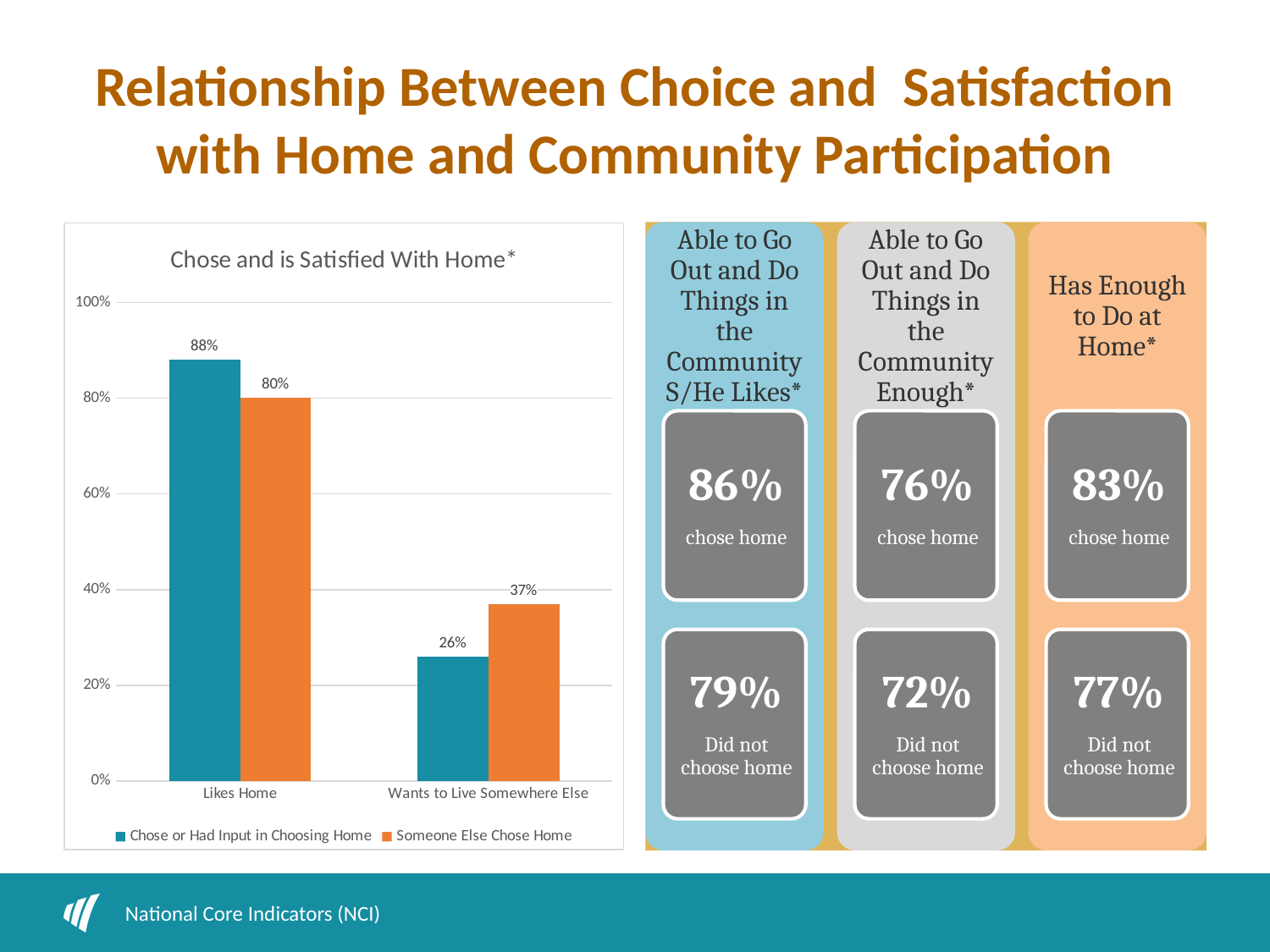
How many series does the chart legend list? 2 What is the difference between the two series' values in the 'Likes Home' category? 8% What is the value for 'Someone Else Chose Home' in the 'Likes Home' category? 80% How many categories are shown on the x axis of the chart? 2 Which category has the highest value for 'Chose or Had Input in Choosing Home'? Likes Home What kind of chart is shown on the slide? Bar chart What is the title of the chart? Chose and is Satisfied With Home* What is the value for 'Chose or Had Input in Choosing Home' in the 'Likes Home' category? 88% What is the value for 'Someone Else Chose Home' in the 'Wants to Live Somewhere Else' category? 37% What is the difference between the two series' values in the 'Wants to Live Somewhere Else' category? 11% In the 'Wants to Live Somewhere Else' category, which series has the larger value? Someone Else Chose Home What is the value for 'Chose or Had Input in Choosing Home' in the 'Wants to Live Somewhere Else' category? 26%